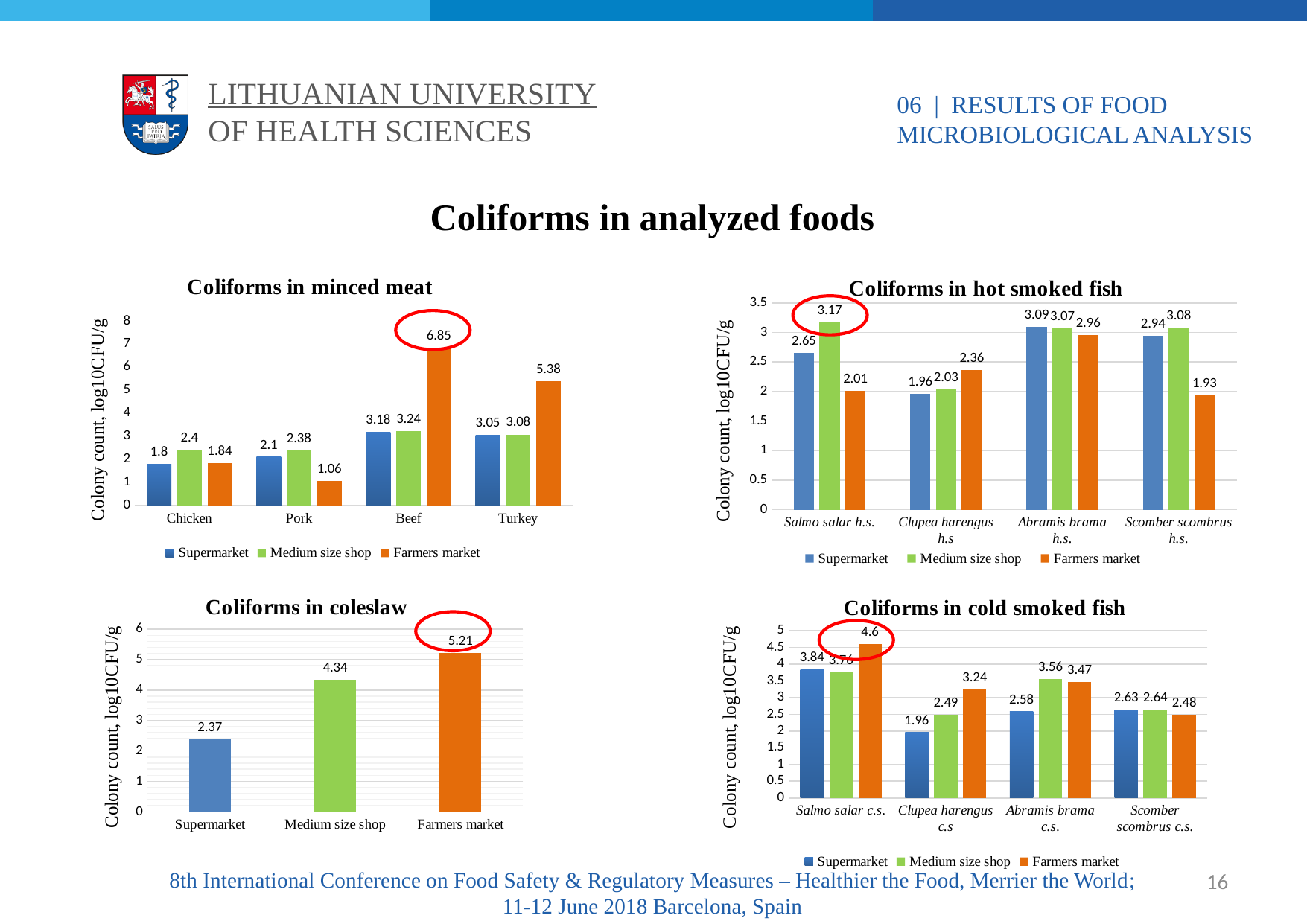
In the 'Coliforms in hot smoked fish' chart, how many series does the legend list? 3 What kind of chart is 'Coliforms in coleslaw'? Bar chart In the 'Coliforms in minced meat' chart, what is the difference between the Farmers market values for Beef and Turkey? 1.47 In the 'Coliforms in minced meat' chart, what is the Farmers market value for Beef? 6.85 In the 'Coliforms in minced meat' chart, which category has the lowest Farmers market value? Pork In the 'Coliforms in coleslaw' chart, which category has the highest value? Farmers market In the 'Coliforms in hot smoked fish' chart, which is larger for Clupea harengus h.s: the Supermarket value or the Farmers market value? Farmers market In the 'Coliforms in coleslaw' chart, what is the value for Medium size shop? 4.34 In the 'Coliforms in cold smoked fish' chart, what is the difference between the Medium size shop and Supermarket values for Abramis brama c.s.? 0.98 In the 'Coliforms in hot smoked fish' chart, what is the Medium size shop value for Salmo salar h.s.? 3.17 In the 'Coliforms in minced meat' chart, how many food categories are shown on the x axis? 4 In the 'Coliforms in cold smoked fish' chart, what is the Farmers market value for Salmo salar c.s.? 4.6